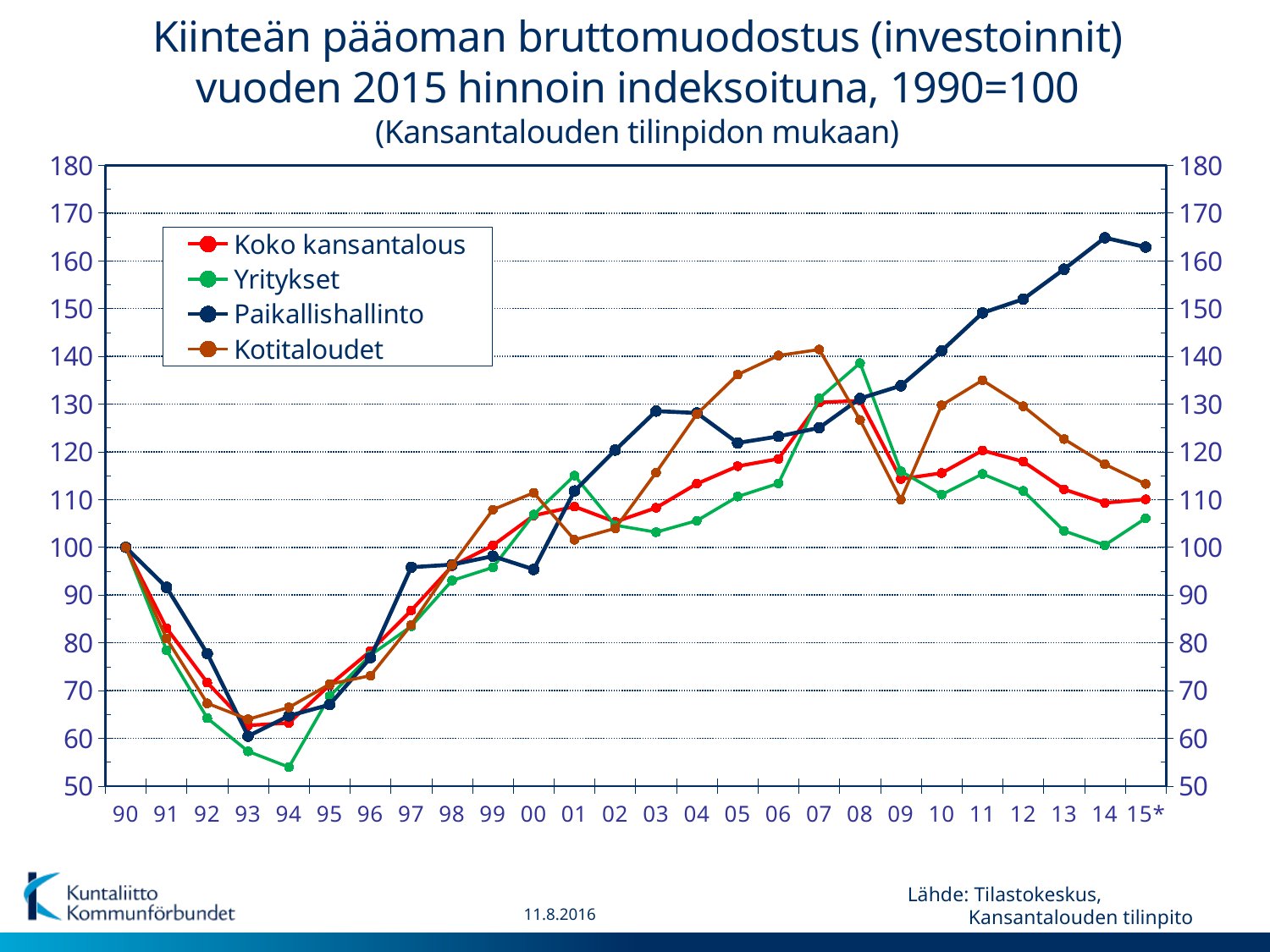
How many series does the legend list? 4 What kind of chart is shown on the slide? line chart Which is larger in 13, Paikallishallinto or Yritykset? Paikallishallinto Is the value for Paikallishallinto in 14 greater or less than 160? greater What is the value of Paikallishallinto in 90? 100 Which series has the highest value in 15*? Paikallishallinto Which series has the lowest value in 94? Yritykset Is the value for Koko kansantalous in 15* greater or less than 100? greater Is the value for Yritykset in 94 greater or less than 60? less Which series is drawn in green in the legend? Yritykset How many years (points) are shown along the x axis? 26 Does the Paikallishallinto series rise or fall from 09 to 14? rise